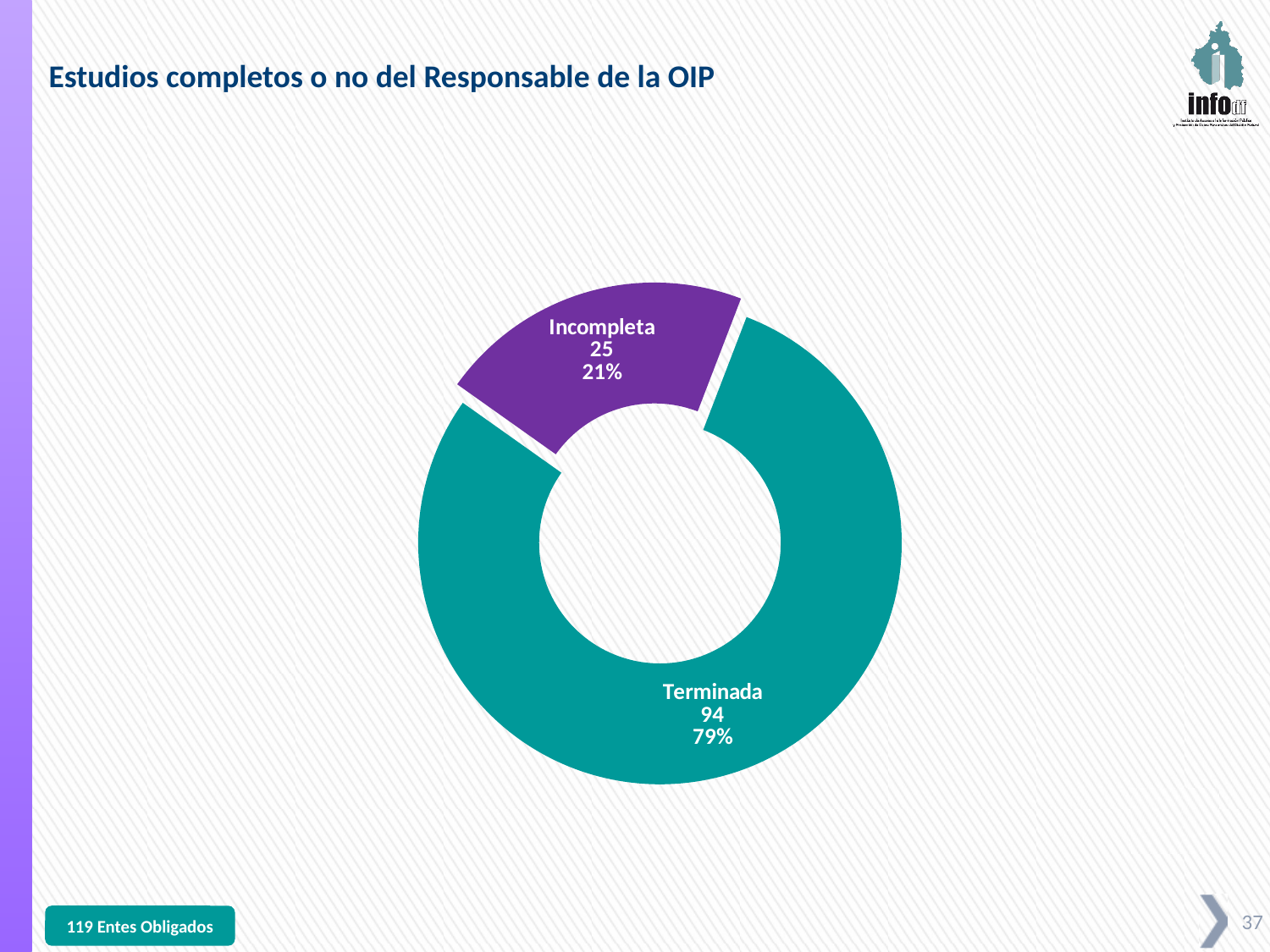
What is the value for Incompleta? 25 What kind of chart is shown on the slide? Doughnut (pie) chart What is the value for Terminada? 94 How many categories does the chart show? 2 What share of the chart does Incompleta represent? 21% What is the difference between the values for Terminada and Incompleta? 69 Which category has the lowest value? Incompleta What is the total of the two categories shown in the chart? 119 Which is larger, Terminada or Incompleta? Terminada What share of the chart does Terminada represent? 79% Which category has the highest value? Terminada What is the title of the slide containing the chart? Estudios completos o no del Responsable de la OIP